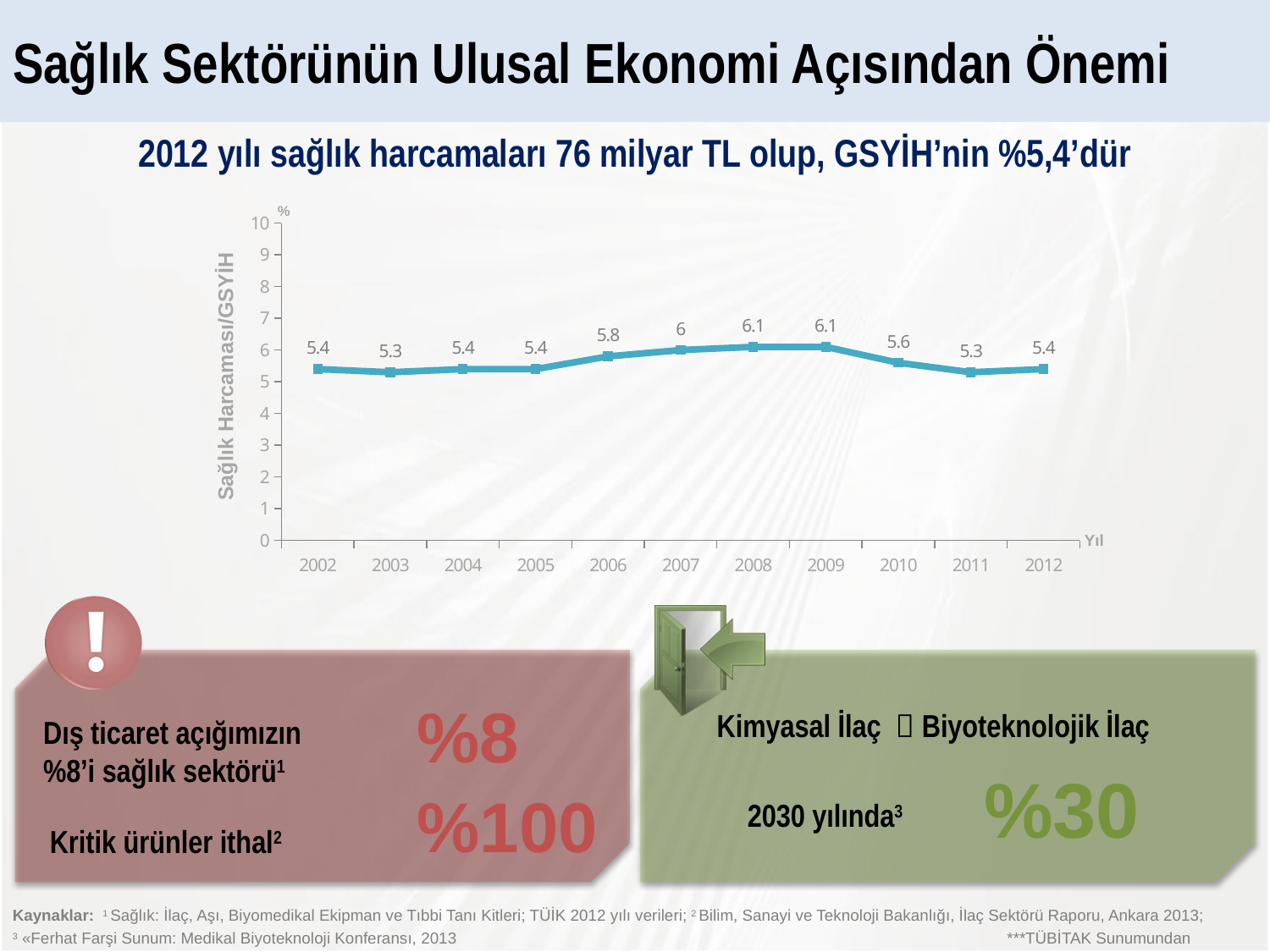
What is the value for 2006 in the line chart? 5.8 What is the lowest value plotted in the line chart? 5.3 What is the value for 2012 in the line chart? 5.4 Which year has the larger value, 2006 or 2010? 2006 What kind of chart is shown on the slide? line chart What is the value for 2007 in the line chart? 6 What is the highest value plotted in the line chart? 6.1 How many years are plotted on the x axis of the line chart? 11 What is the value for 2010 in the line chart? 5.6 What is the label of the vertical axis of the line chart? Sağlık Harcaması/GSYİH What is the difference between the values for 2008 and 2011? 0.8 In which years does the line chart reach its highest value? 2008 and 2009